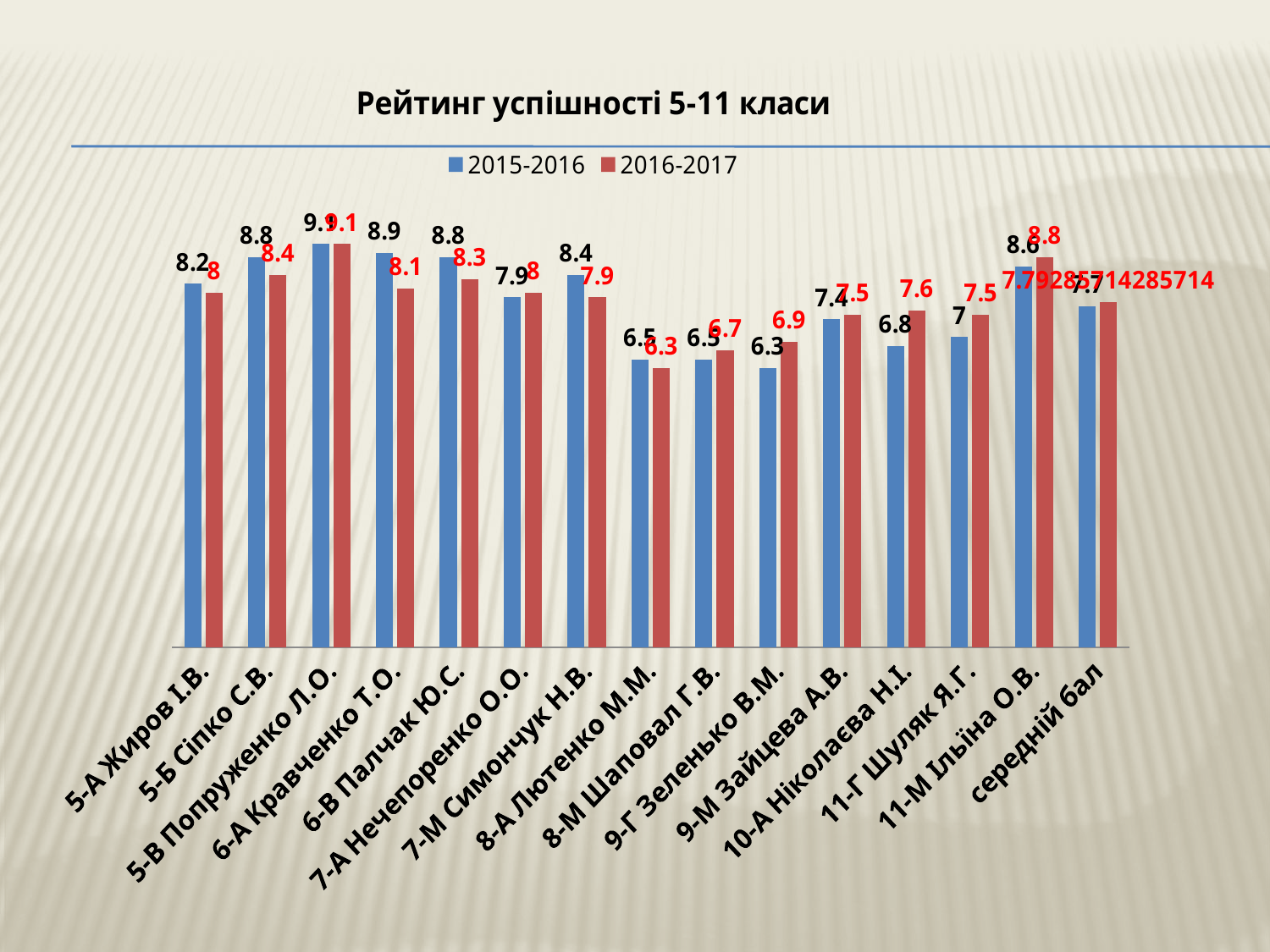
How many categories are shown along the x axis? 15 What is the 2016-2017 value for 10-А Ніколаєва Н.І.? 7.6 What kind of chart is shown on the slide? bar chart What are the two series named in the legend? 2015-2016 and 2016-2017 What is the 2016-2017 value for 6-А Кравченко Т.О.? 8.1 How many series does the legend list? 2 Which category has the highest 2015-2016 value? 5-В Попруженко Л.О. What is the difference between the 2015-2016 and 2016-2017 values for 6-А Кравченко Т.О.? 0.8 Which category has the lowest 2016-2017 value? 8-А Лютенко М.М. For 7-М Симончук Н.В., which series has the larger value, 2015-2016 or 2016-2017? 2015-2016 What is the 2015-2016 value for 5-А Жиров І.В.? 8.2 Which category has the lowest 2015-2016 value? 9-Г Зеленько В.М.